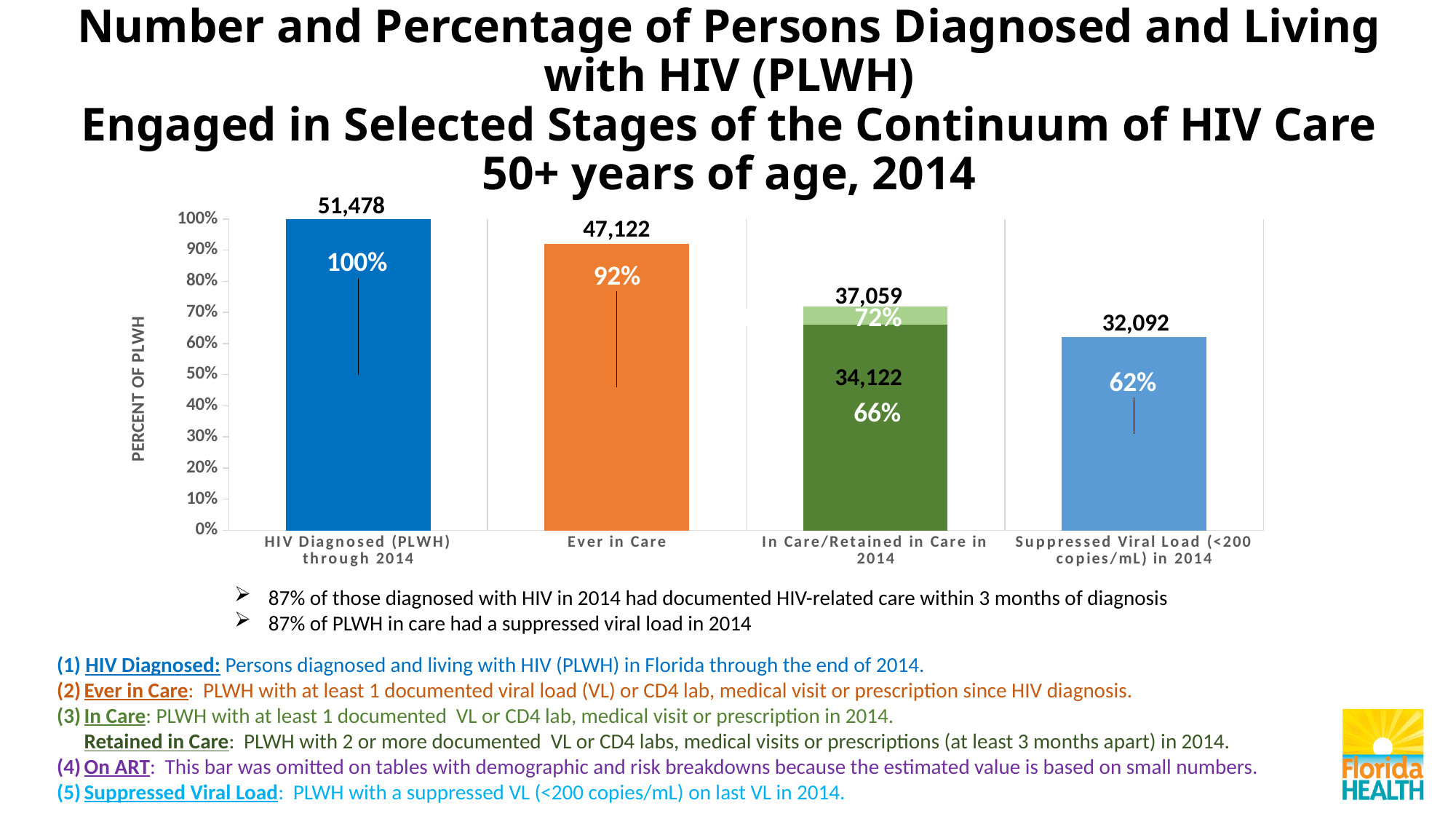
Which category has the lowest percentage of PLWH? Suppressed Viral Load (<200 copies/mL) in 2014 What percentage is shown for Ever in Care? 92% What number is shown above the bar for HIV Diagnosed (PLWH) through 2014? 51,478 What number is shown above the bar for Suppressed Viral Load (<200 copies/mL) in 2014? 32,092 What percentage is shown in the dark green portion of the In Care/Retained in Care in 2014 bar? 66% What kind of chart is shown on the slide? Bar chart Which category has the highest number of persons? HIV Diagnosed (PLWH) through 2014 What number is shown at the top of the In Care/Retained in Care in 2014 bar? 37,059 What percentage is shown for Suppressed Viral Load (<200 copies/mL) in 2014? 62% What is the difference in number of persons between HIV Diagnosed (PLWH) through 2014 and Ever in Care? 4,356 Which is larger, the percentage for Ever in Care or the percentage for Suppressed Viral Load (<200 copies/mL) in 2014? Ever in Care How many categories are shown on the x axis of the chart? 4